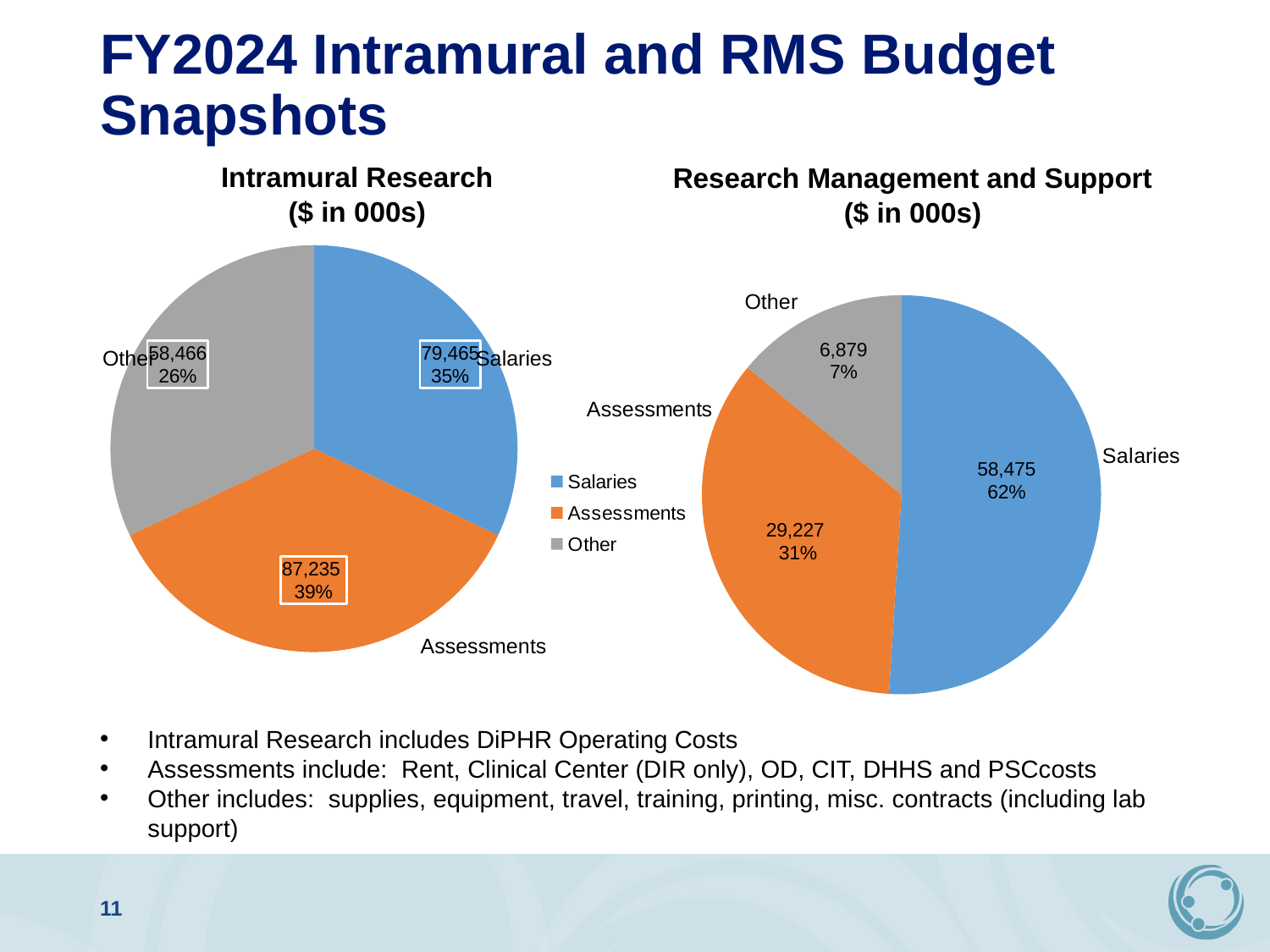
What kind of chart is the Intramural Research chart? Pie chart In the Research Management and Support chart, what is the value for Other? 6,879 In the Intramural Research chart, what share of the pie is Other? 26% Which colour represents Assessments in the legend? Orange In the Research Management and Support chart, what is the value for Salaries? 58,475 In the Intramural Research chart, which category is the largest? Assessments In the Research Management and Support chart, which is larger, Salaries or Assessments? Salaries In the Intramural Research chart, what is the difference between Assessments and Salaries? 7,770 In the Research Management and Support chart, what share of the pie is Assessments? 31% In the Intramural Research chart, what is the value for Assessments? 87,235 In the Research Management and Support chart, which category is the smallest? Other How many categories does the Research Management and Support chart show? 3